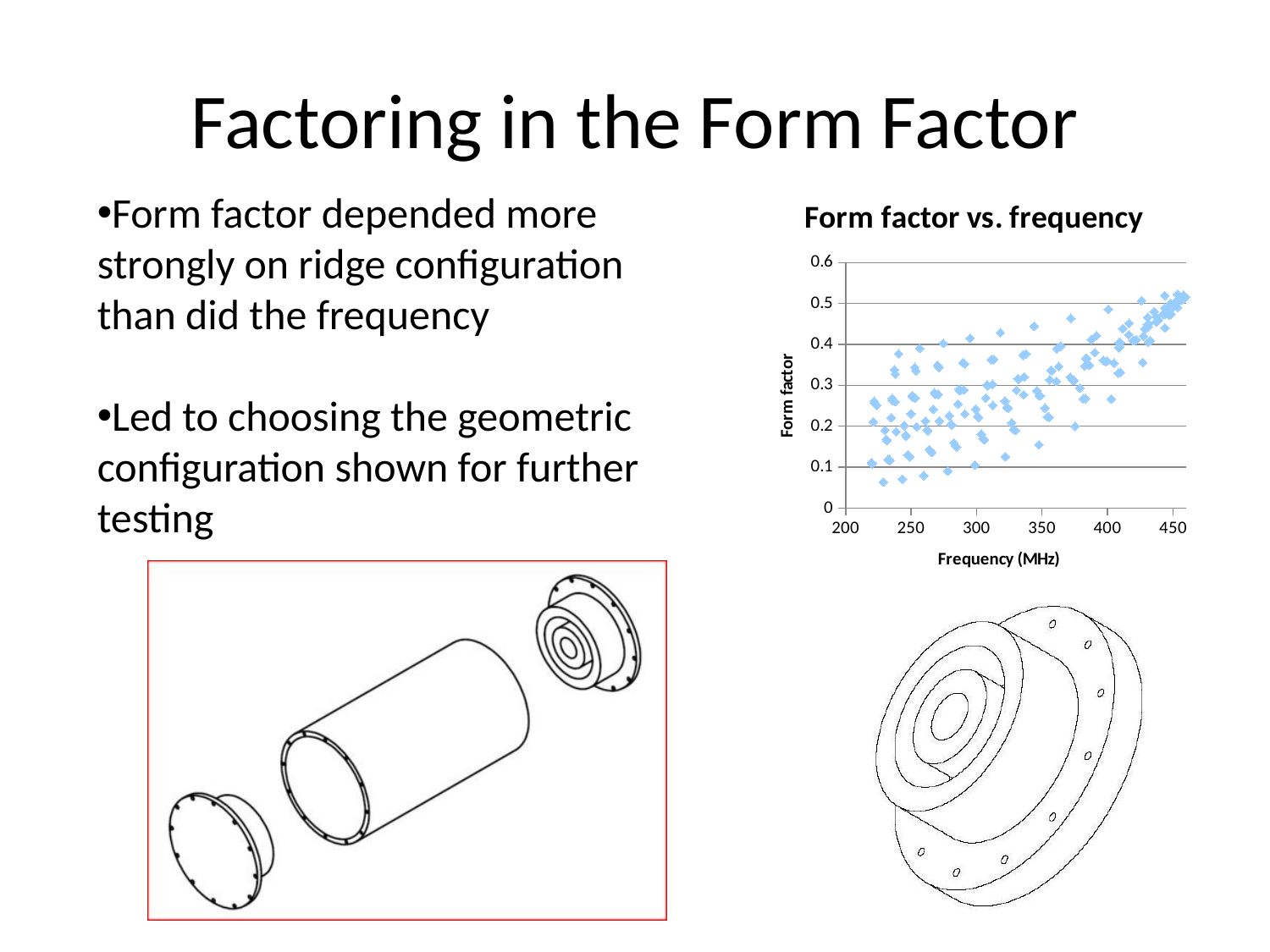
Is the lowest frequency plotted on the chart greater or less than 250 MHz? less Is the highest form factor value plotted on the chart greater or less than 0.6? less Is the highest frequency plotted on the chart greater or less than 450 MHz? greater What is the title of the chart on the slide? Form factor vs. frequency What kind of chart is shown on the slide? scatter chart Do the form factor values generally rise or fall as frequency increases along the x axis? rise What is the label of the x axis of the chart? Frequency (MHz)